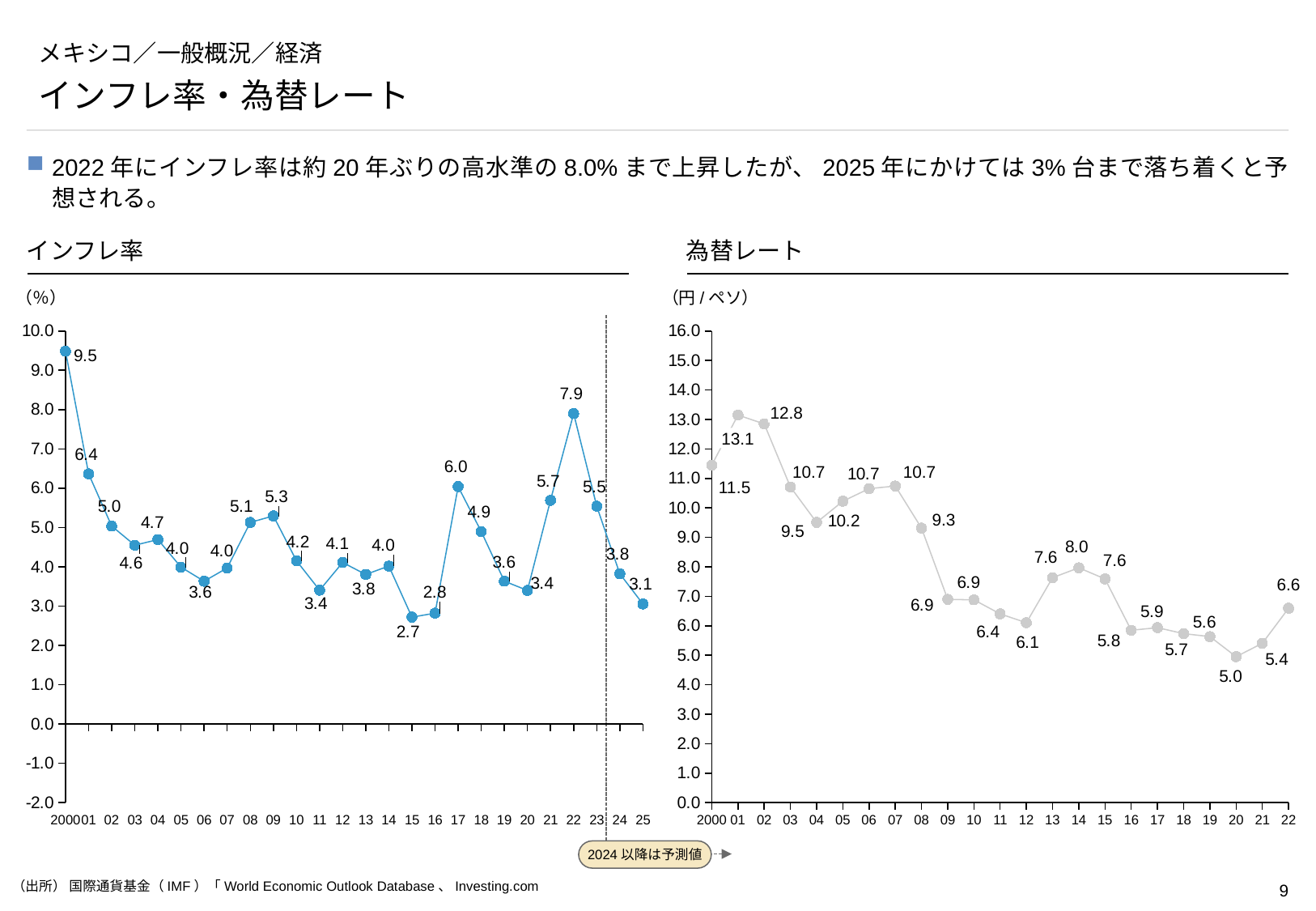
In the インフレ率 chart, what is the forecast value for 2025? 3.1 What type of chart is the 為替レート chart? Line chart In the インフレ率 chart, what is the value for 2000? 9.5 In the インフレ率 chart, which is larger, the value for 2017 or the value for 2021? 2017 In the インフレ率 chart, what is the inflation rate for 2022? 7.9 In the 為替レート chart, what is the difference between the 2014 value and the 2016 value? 2.2 In the インフレ率 chart, what is the difference between the 2022 value and the 2023 value? 2.4 In the 為替レート chart, how many years are plotted? 23 In the 為替レート chart, which year has the lowest value? 2020 What unit is shown on the y axis of the 為替レート chart? 円/ペソ In the 為替レート chart, what is the value for 2001? 13.1 In the インフレ率 chart, which year has the lowest inflation rate? 2015